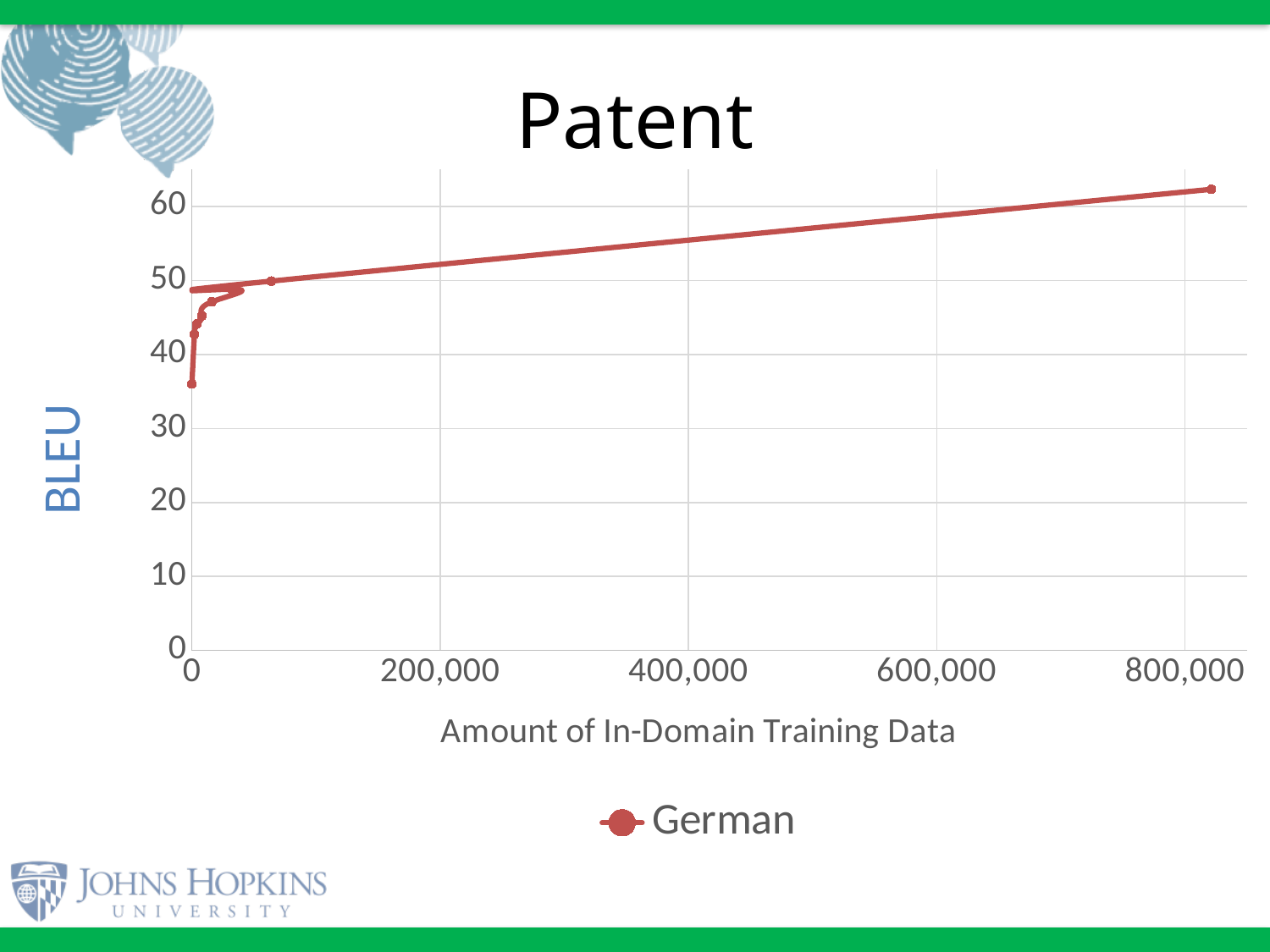
What kind of chart is shown on the slide? line chart What is the name of the series shown in the legend? German Is the BLEU value at the smallest amount of in-domain training data greater or less than 30? greater Which has the higher BLEU score: the point with the most training data or the point with the least training data? the point with the most training data Does the BLEU score rise or fall as the amount of in-domain training data increases? rise Is the highest BLEU value plotted for German greater or less than 60? greater What is the title of the chart? Patent Is the lowest BLEU value plotted for German greater or less than 40? less How many series does the legend list? 1